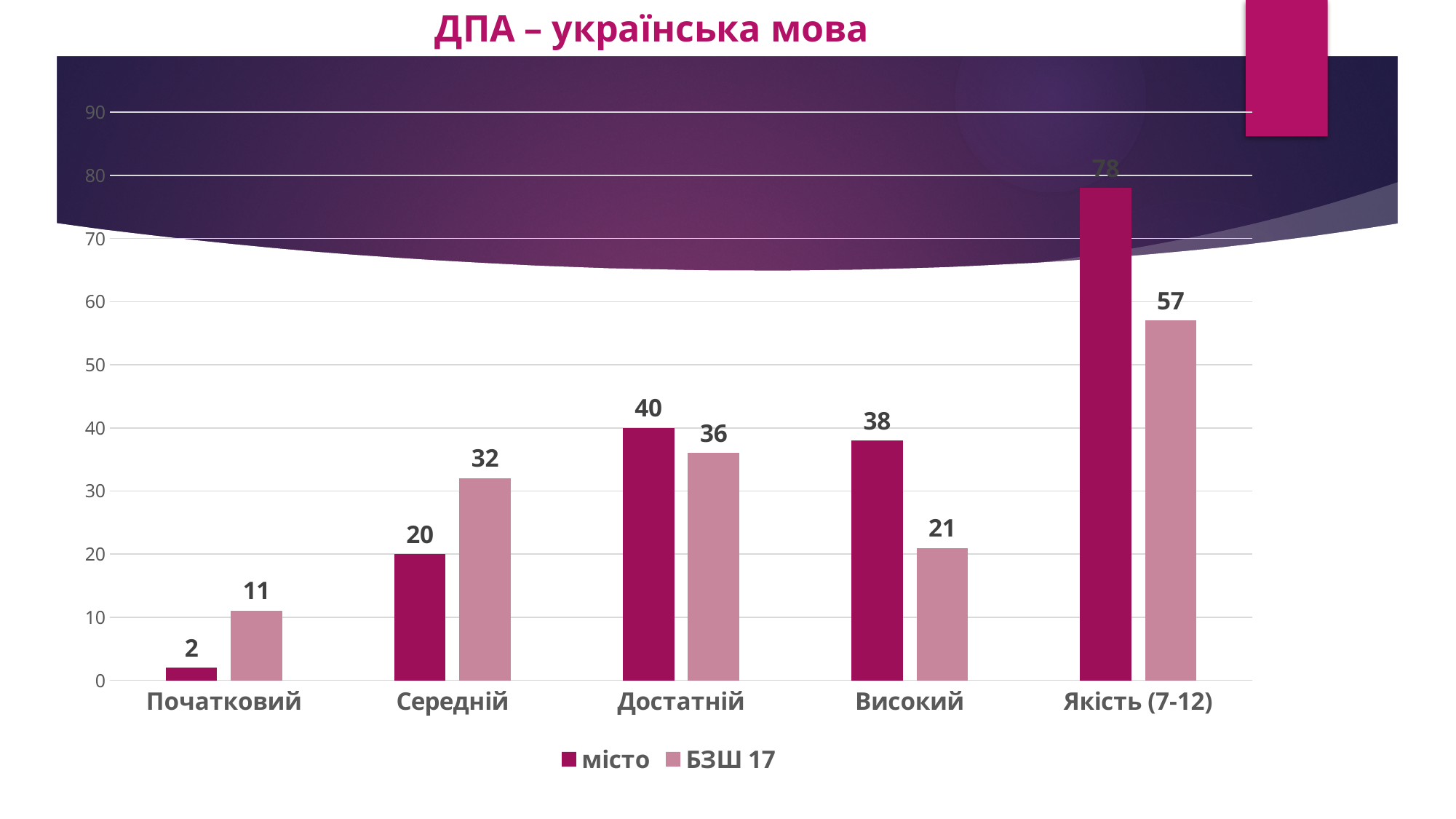
What kind of chart is shown on the slide? bar chart Which is larger in the Середній category, місто or БЗШ 17? БЗШ 17 How many categories are shown on the x axis? 5 What is the value for місто in the Достатній category? 40 What is the title of the chart? ДПА – українська мова Which category has the highest value for місто? Якість (7-12) What is the value for БЗШ 17 in the Якість (7-12) category? 57 What is the value for БЗШ 17 in the Початковий category? 11 Which category has the lowest value for БЗШ 17? Початковий What is the difference between місто and БЗШ 17 in the Високий category? 17 How many series does the legend list? 2 Is the value for місто in the Якість (7-12) category greater or less than 70? greater